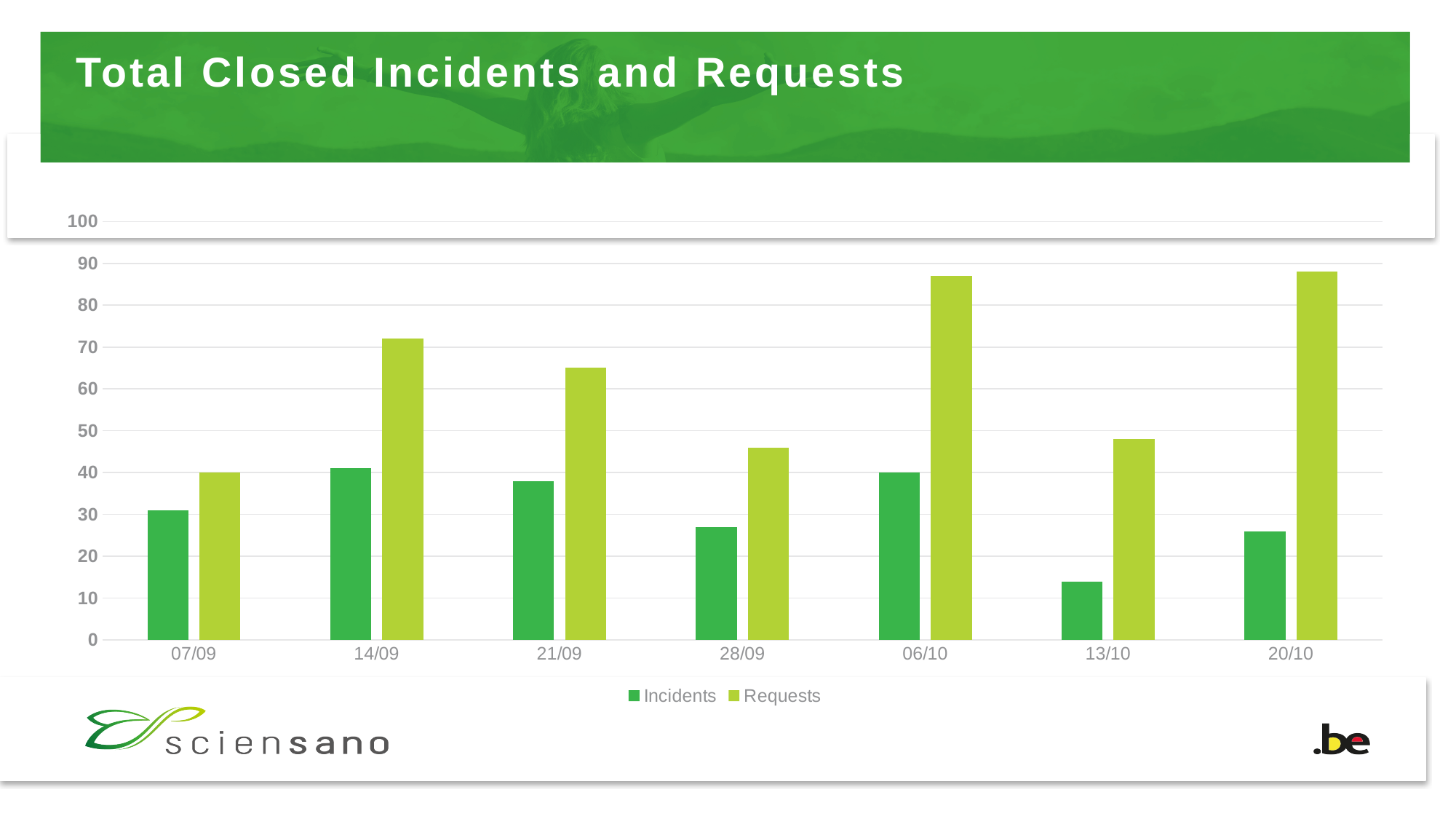
What kind of chart is shown on the slide? bar chart On 14/09, which is larger: Incidents or Requests? Requests Is the Requests value for 06/10 greater or less than 80? greater Which date has the larger Requests value: 14/09 or 21/09? 14/09 On which date is the Incidents bar lowest? 13/10 How many dates are shown on the x axis of the chart? 7 What is the title of the chart on the slide? Total Closed Incidents and Requests Which series does the lighter green colour represent in the chart? Requests On which date is the Requests bar lowest? 07/09 How many series does the chart legend list? 2 Is the Incidents value for 13/10 greater or less than 20? less Is the Requests value for 21/09 greater or less than 60? greater